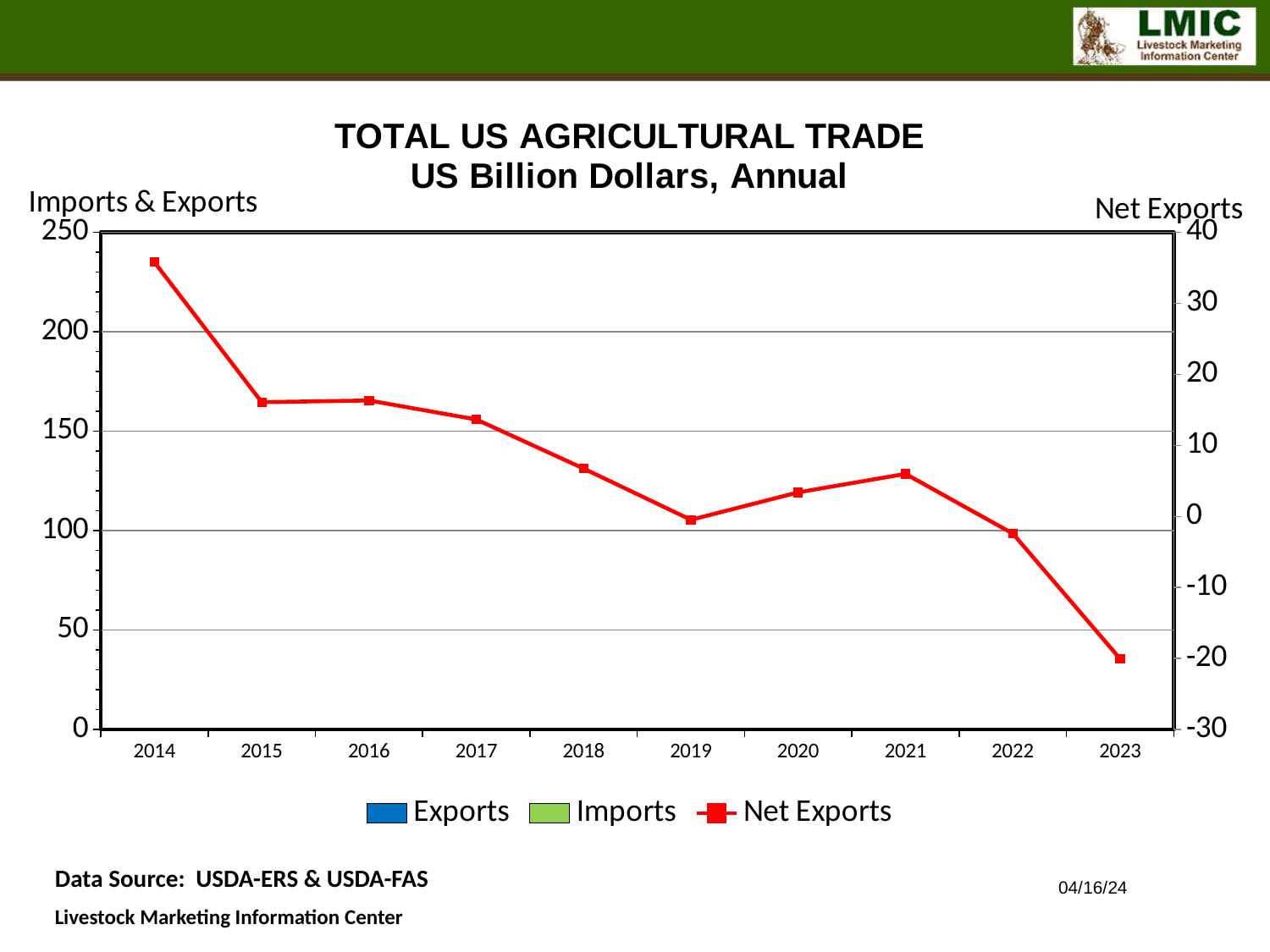
How many years are shown on the x axis? 10 Which is larger, the Net Exports value for 2021 or for 2023? 2021 Does the Net Exports line generally rise or fall from 2014 to 2023? fall How many series does the legend list? 3 Which year has the lowest Net Exports value? 2023 Is the Net Exports value for 2023 greater or less than -10? less What is the label of the right-hand vertical axis? Net Exports Is the Net Exports value for 2014 greater or less than 30? greater Which year has the highest Net Exports value? 2014 Is the Net Exports value for 2015 greater or less than 10? greater Which is larger, the Net Exports value for 2018 or for 2022? 2018